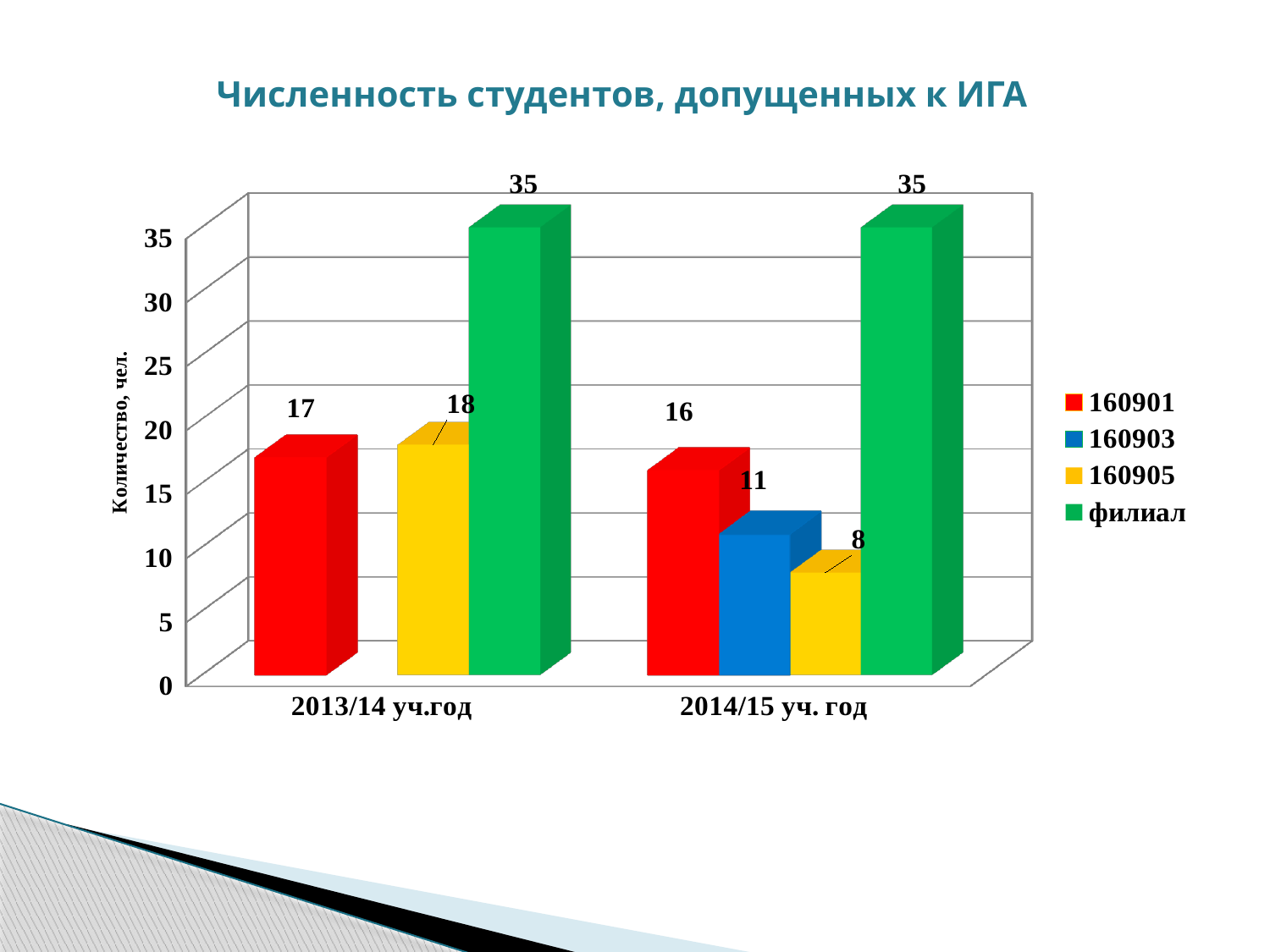
Which series has the highest value in 2014/15 уч. год? филиал What kind of chart is shown on the slide? bar chart What is the value for 160901 in 2013/14 уч.год? 17 Which is larger: the 160901 value in 2013/14 уч.год or in 2014/15 уч. год? 2013/14 уч.год How many categories are shown on the x axis? 2 What is the title of the chart? Численность студентов, допущенных к ИГА Which series has the lowest value in 2014/15 уч. год? 160905 What is the difference between the 160905 values for 2013/14 уч.год and 2014/15 уч. год? 10 What is the value for филиал in 2013/14 уч.год? 35 How many series does the legend list? 4 What is the value for 160903 in 2014/15 уч. год? 11 What is the value for 160905 in 2014/15 уч. год? 8